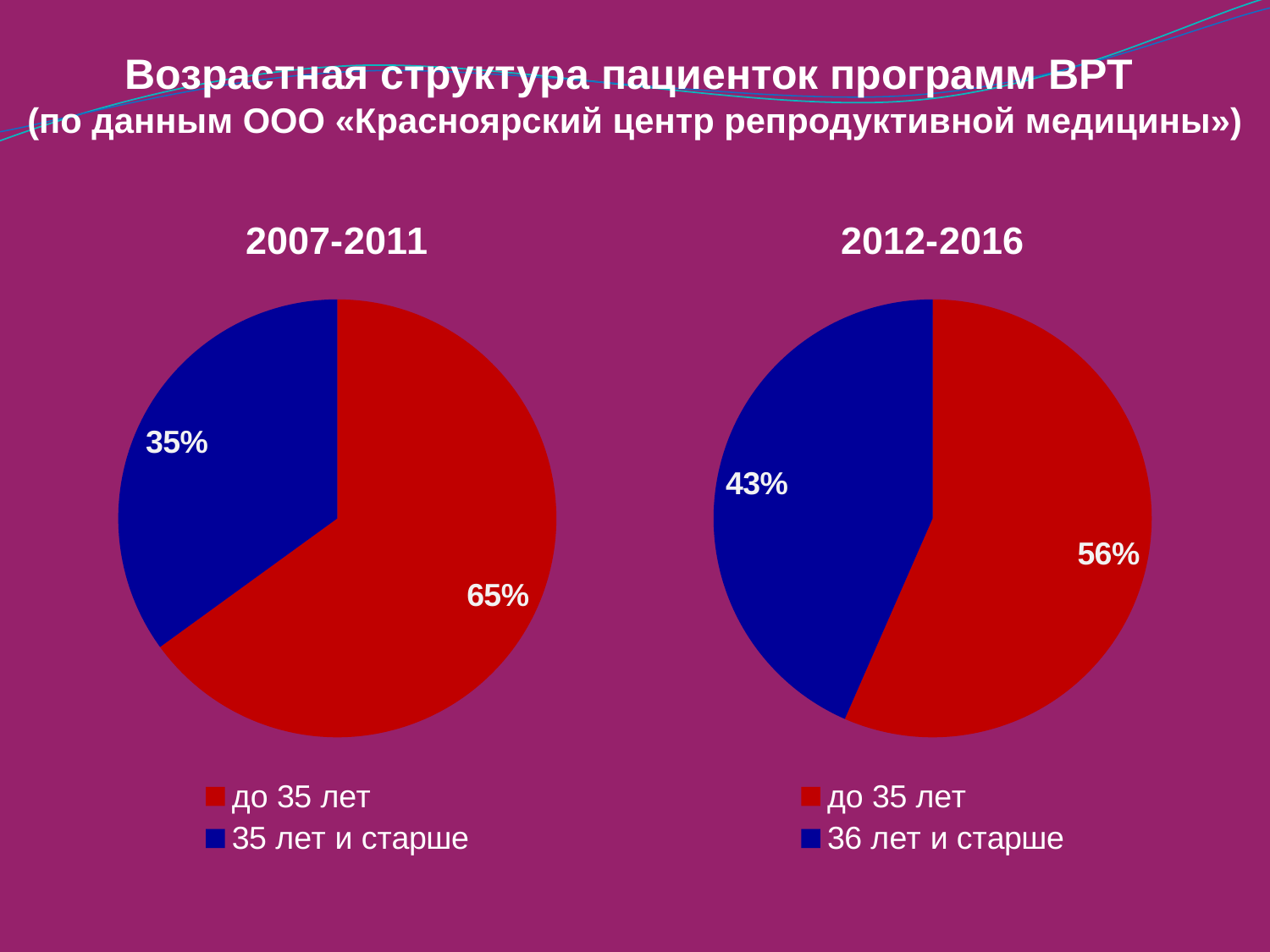
In the 2012-2016 chart, what share of patients are "36 лет и старше"? 43% In the 2012-2016 chart, what share of patients are "до 35 лет"? 56% In the 2012-2016 chart, which category has the smallest slice? 36 лет и старше Is the "до 35 лет" share larger in the 2007-2011 chart or the 2012-2016 chart? 2007-2011 In the 2012-2016 chart, what is the difference between the "до 35 лет" and "36 лет и старше" shares? 13% What kind of chart is the 2012-2016 chart? pie chart In the 2007-2011 chart, which category has the largest slice? до 35 лет In the 2007-2011 chart, what share of patients are "до 35 лет"? 65% In the 2007-2011 chart, what share of patients are "35 лет и старше"? 35% In the 2012-2016 chart, what colour is the "до 35 лет" slice? red In the 2007-2011 chart, what is the difference between the "до 35 лет" and "35 лет и старше" shares? 30% How many categories does the legend of the 2007-2011 chart list? 2